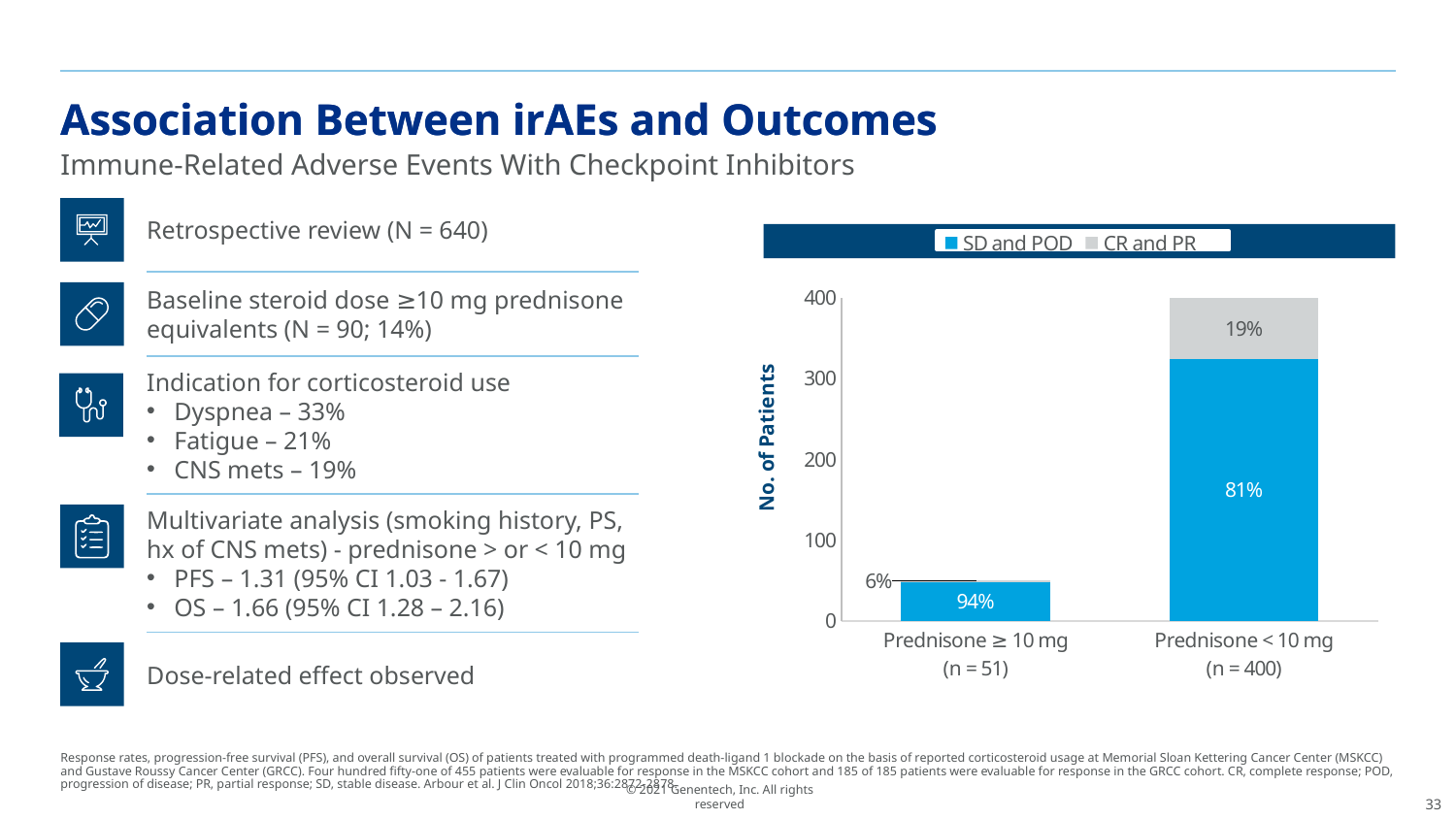
What is the label of the y axis of the chart? No. of Patients Which group has the taller bar in terms of number of patients, Prednisone ≥ 10 mg or Prednisone < 10 mg? Prednisone < 10 mg What is the CR and PR percentage label for the Prednisone ≥ 10 mg group? 6% What is the difference in percentage points between the SD and POD labels of the Prednisone ≥ 10 mg group and the Prednisone < 10 mg group? 13% How many categories are shown on the x axis of the chart? 2 What is the CR and PR percentage label for the Prednisone < 10 mg group? 19% What is the SD and POD percentage label for the Prednisone < 10 mg group? 81% How many series does the chart legend list? 2 Is the total number of patients in the Prednisone < 10 mg bar greater or less than 300? greater Is the total number of patients in the Prednisone ≥ 10 mg bar greater or less than 100? less What type of chart is shown on the slide? Stacked bar chart What is the SD and POD percentage label for the Prednisone ≥ 10 mg group? 94%